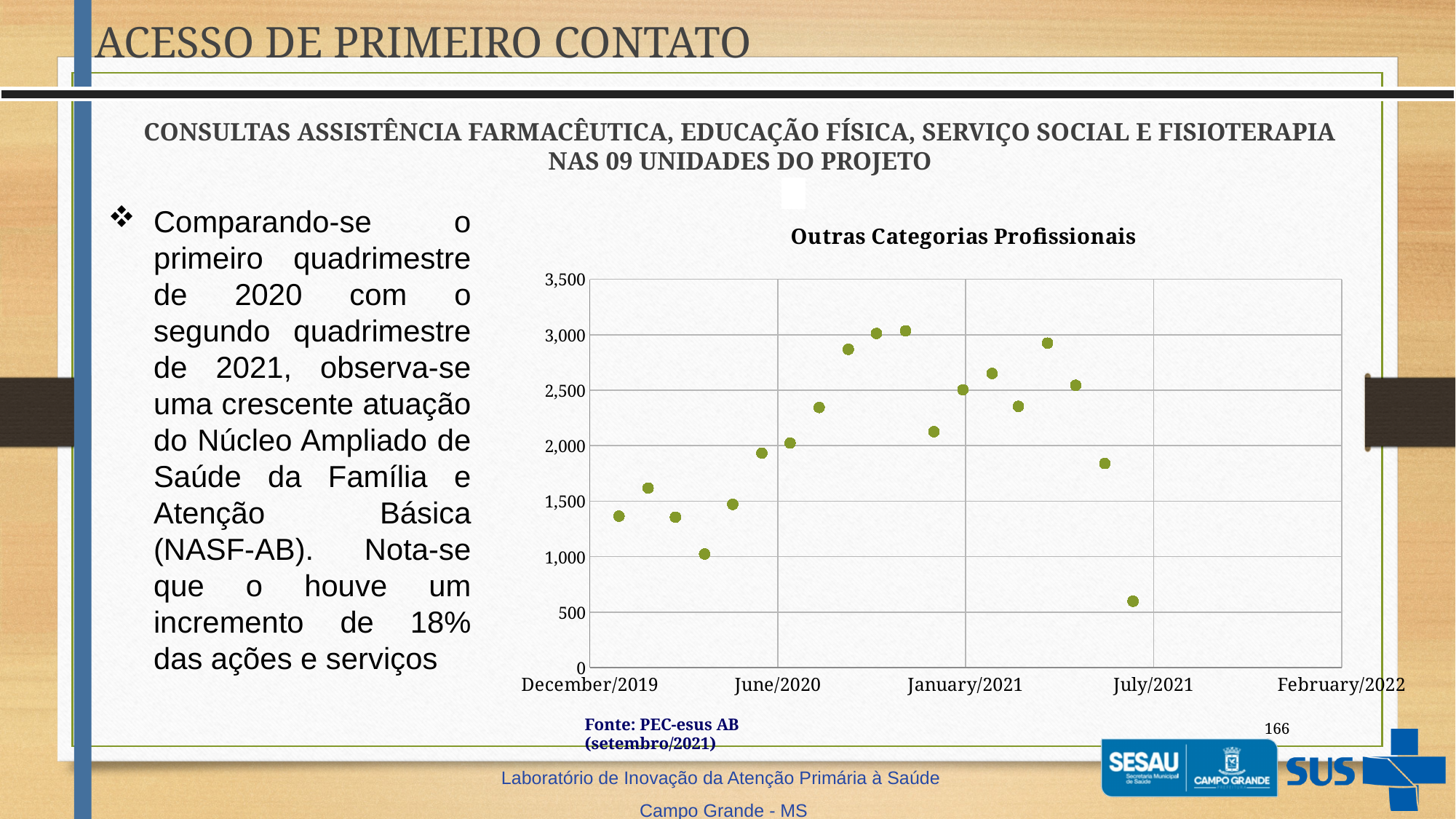
What is the maximum value shown on the vertical axis of the chart? 3,500 Is the highest plotted value in the chart greater or less than 2,500? greater What kind of chart is shown on the slide? scatter chart Is the lowest plotted value in the chart greater or less than 1,000? less Is the lowest plotted value in the chart greater or less than 500? greater Which is larger: the first plotted value near December/2019 or the last plotted value near July/2021? the first value near December/2019 Do the plotted values generally rise or fall from December/2019 to January/2021? rise What is the title of the chart on the slide? Outras Categorias Profissionais How many data points are plotted in the chart? 19